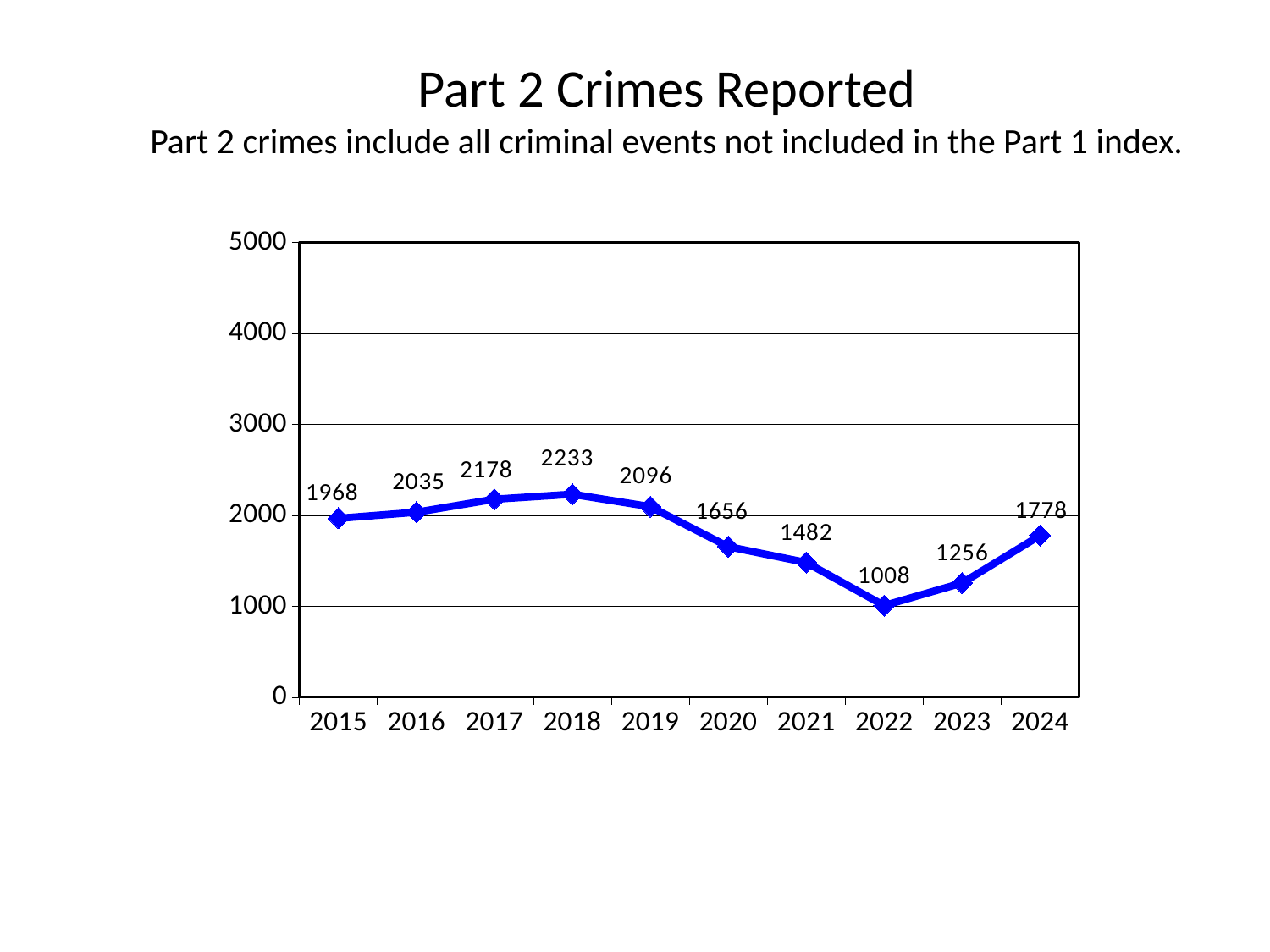
What kind of chart is shown? line chart What is the difference between the values for 2018 and 2022? 1225 What is the difference between the values for 2024 and 2023? 522 Which year has the highest value? 2018 Do the values rise or fall from 2018 to 2022? fall What is the value for 2024? 1778 What is the value for 2022? 1008 Is the value for 2021 greater or less than 2000? less How many years are plotted on the chart? 10 Which is larger, the value for 2015 or the value for 2020? 2015 What is the value for 2018? 2233 Which year has the lowest value? 2022